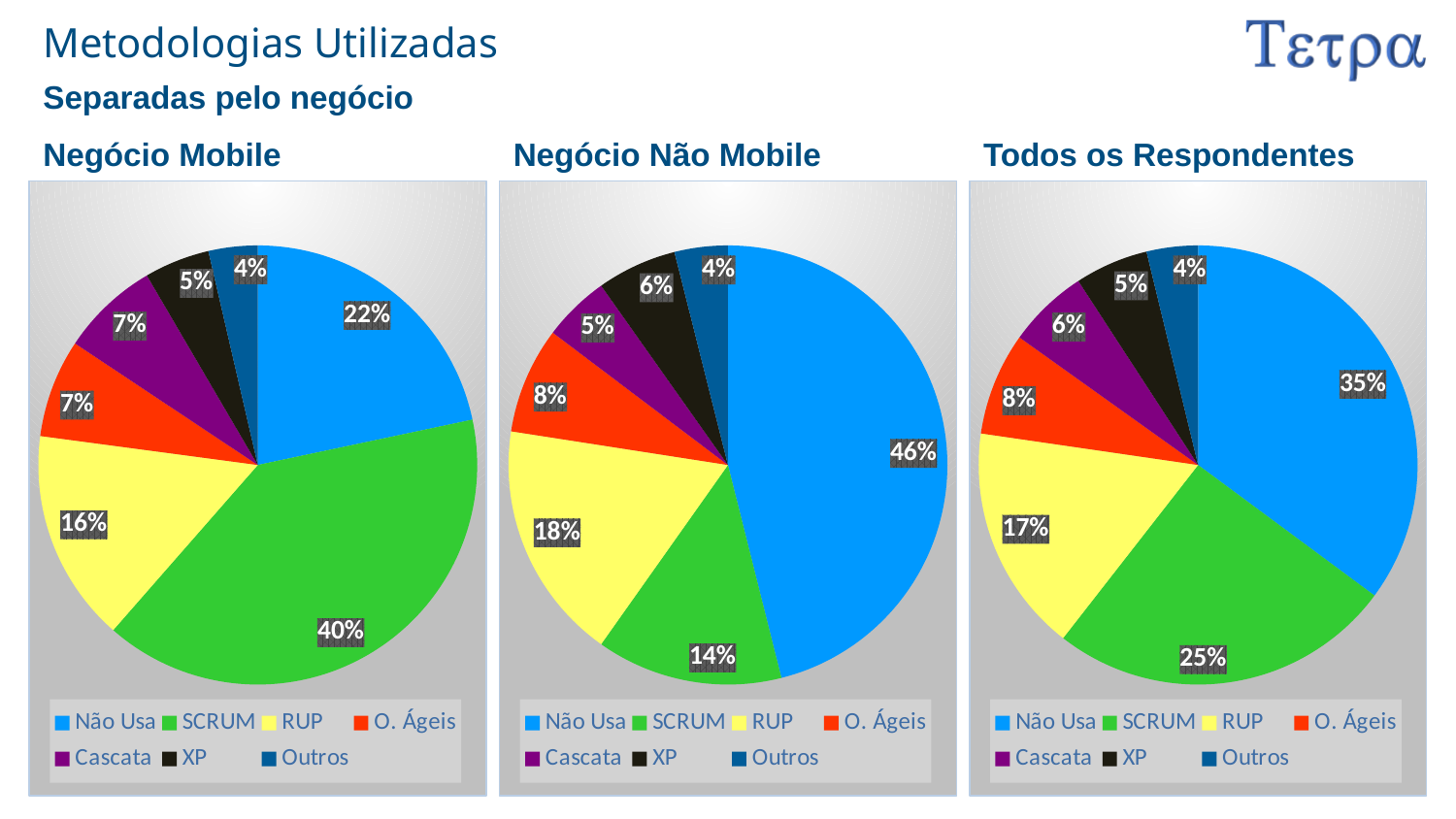
What colour represents XP in the Todos os Respondentes chart? Black What type of chart is the Negócio Não Mobile chart? Pie chart In the Negócio Não Mobile chart, which category has the smallest slice? Outros In the Negócio Mobile chart, what share is SCRUM? 40% In the Negócio Mobile chart, what share is Cascata? 7% In the Negócio Não Mobile chart, which is larger, RUP or SCRUM? RUP In the Negócio Não Mobile chart, what share is Não Usa? 46% In the Negócio Mobile chart, which category has the largest slice? SCRUM How many slices does the Negócio Mobile chart have? 7 How many entries does the legend of the Todos os Respondentes chart list? 7 In the Todos os Respondentes chart, what share is RUP? 17% In the Todos os Respondentes chart, what is the difference between the Não Usa and SCRUM shares? 10%